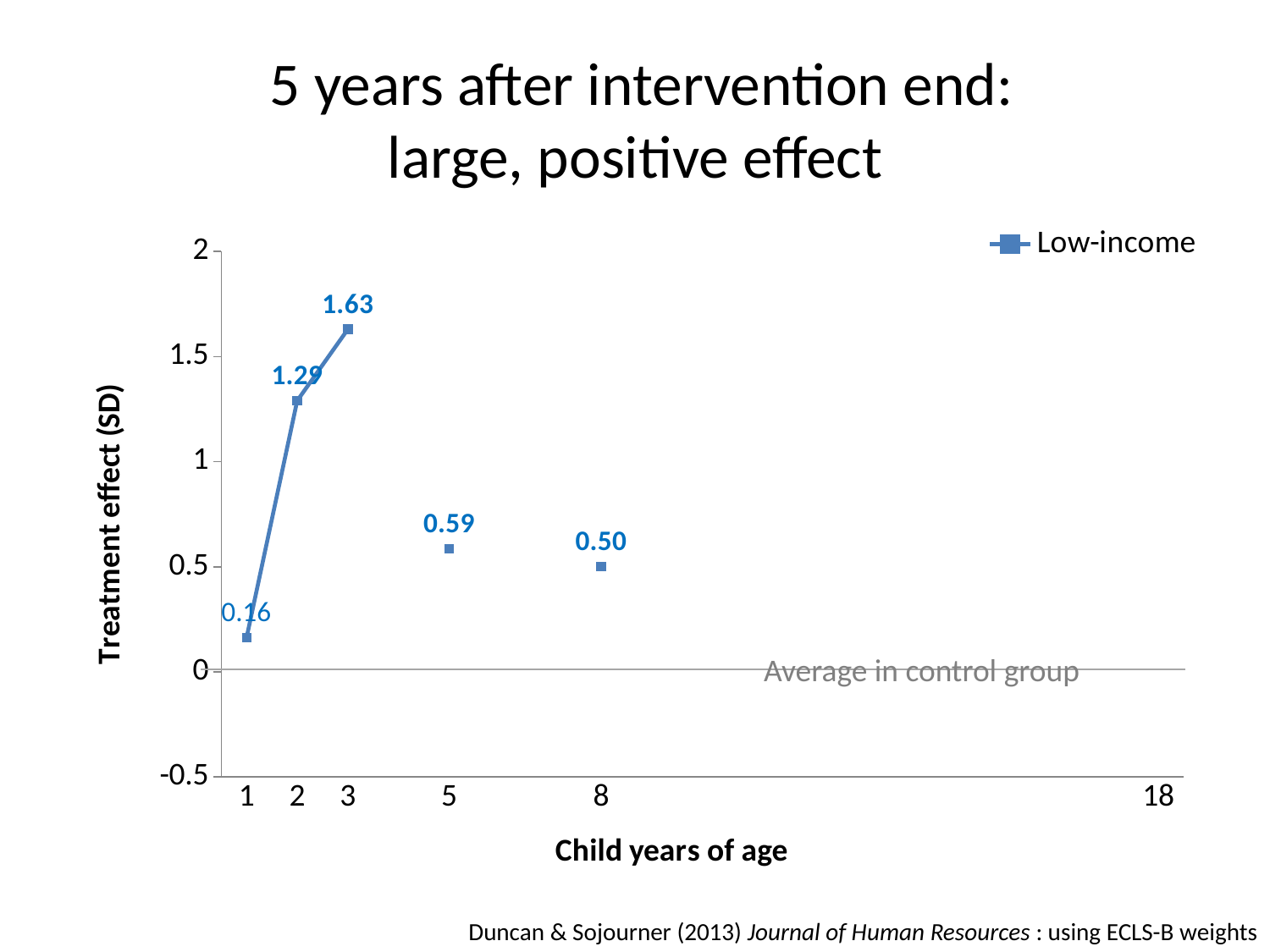
What is the treatment effect at child age 1? 0.16 Is the treatment effect at age 2 greater or less than 1? greater What is the label of the y axis? Treatment effect (SD) How many series does the legend list? 1 At which child age is the treatment effect highest? 3 What is the difference between the treatment effect at age 3 and at age 2? 0.34 How many data points are plotted for the Low-income series? 5 What is the difference between the treatment effect at age 5 and at age 8? 0.09 At which child age is the treatment effect lowest? 1 Which is larger, the treatment effect at age 2 or at age 5? age 2 What is the treatment effect for the Low-income series at child age 3? 1.63 What is the treatment effect at child age 8? 0.50